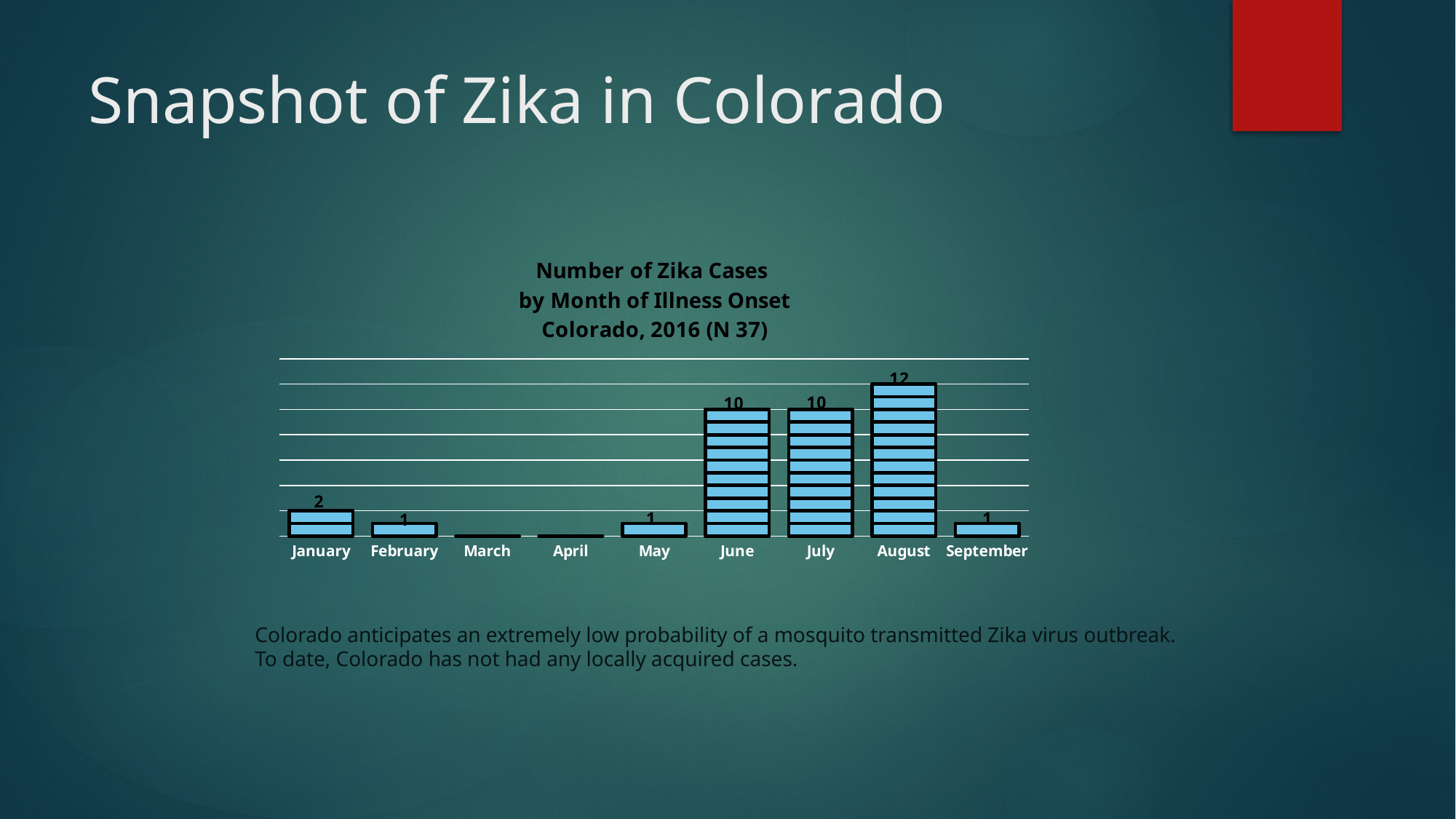
How many Zika cases had illness onset in August? 12 How many Zika cases had illness onset in June? 10 How many months are shown on the x axis of the chart? 9 How many Zika cases had illness onset in September? 1 Which month has more Zika cases, January or May? January Which month has more Zika cases, August or June? August Which month has the highest number of Zika cases? August What is the total number of cases (N) stated in the chart title? 37 What is the difference in Zika cases between August and July? 2 What kind of chart is shown on the slide? Bar chart How many Zika cases had illness onset in January? 2 What is the difference in Zika cases between January and February? 1